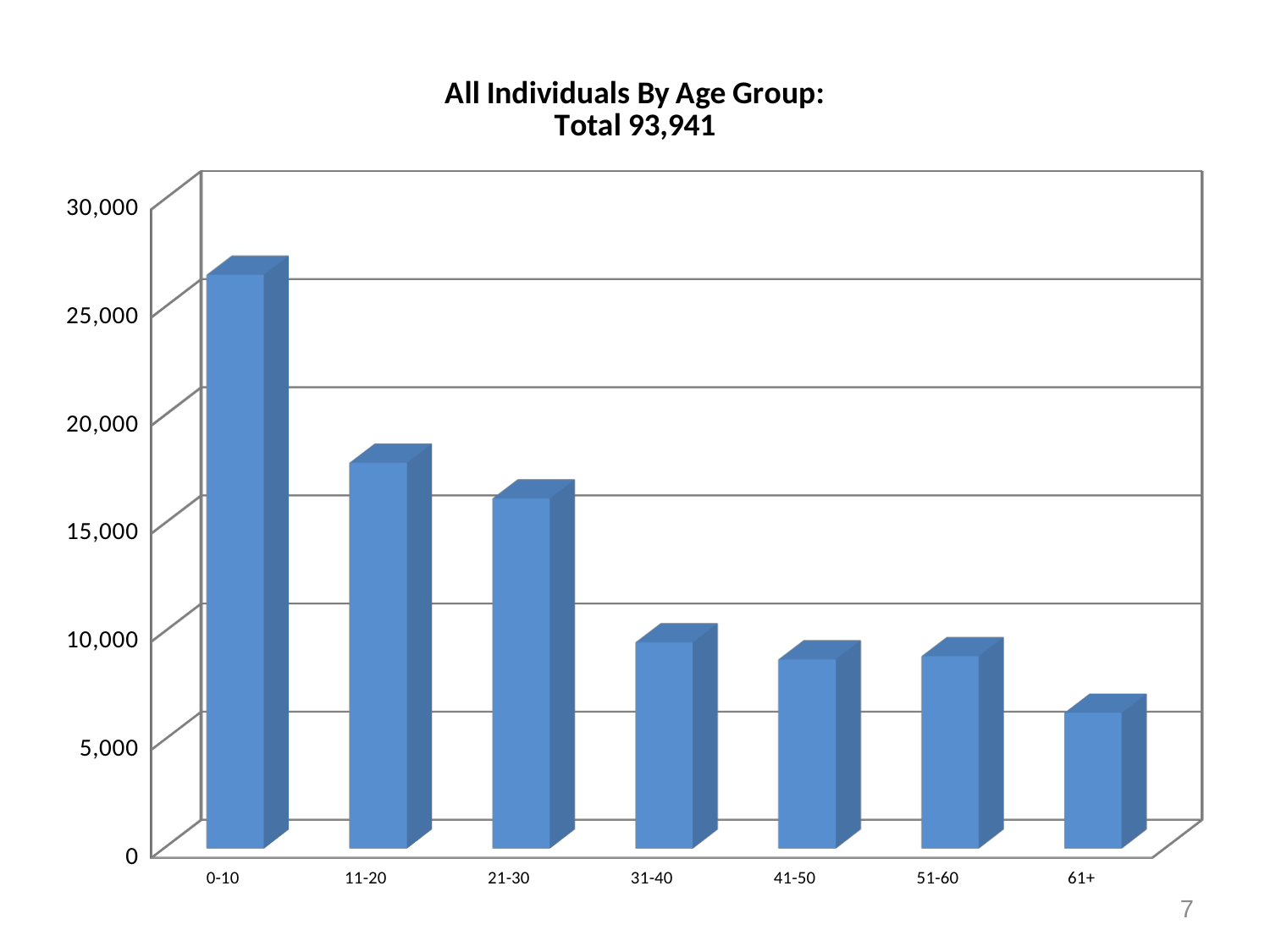
Do the values generally rise or fall as the age groups increase along the x axis? fall Is the value for the 11-20 age group greater or less than 20,000? less Is the value for the 0-10 age group greater or less than 25,000? greater Which is larger, the value for 31-40 or the value for 61+? 31-40 What total number of individuals is stated in the chart title? 93,941 Which age group has the lowest value? 61+ Which age group has the highest value? 0-10 What kind of chart is shown on the slide? Bar chart How many age groups are shown on the x axis? 7 Which is larger, the value for 11-20 or the value for 21-30? 11-20 Is the value for the 61+ age group greater or less than 5,000? greater